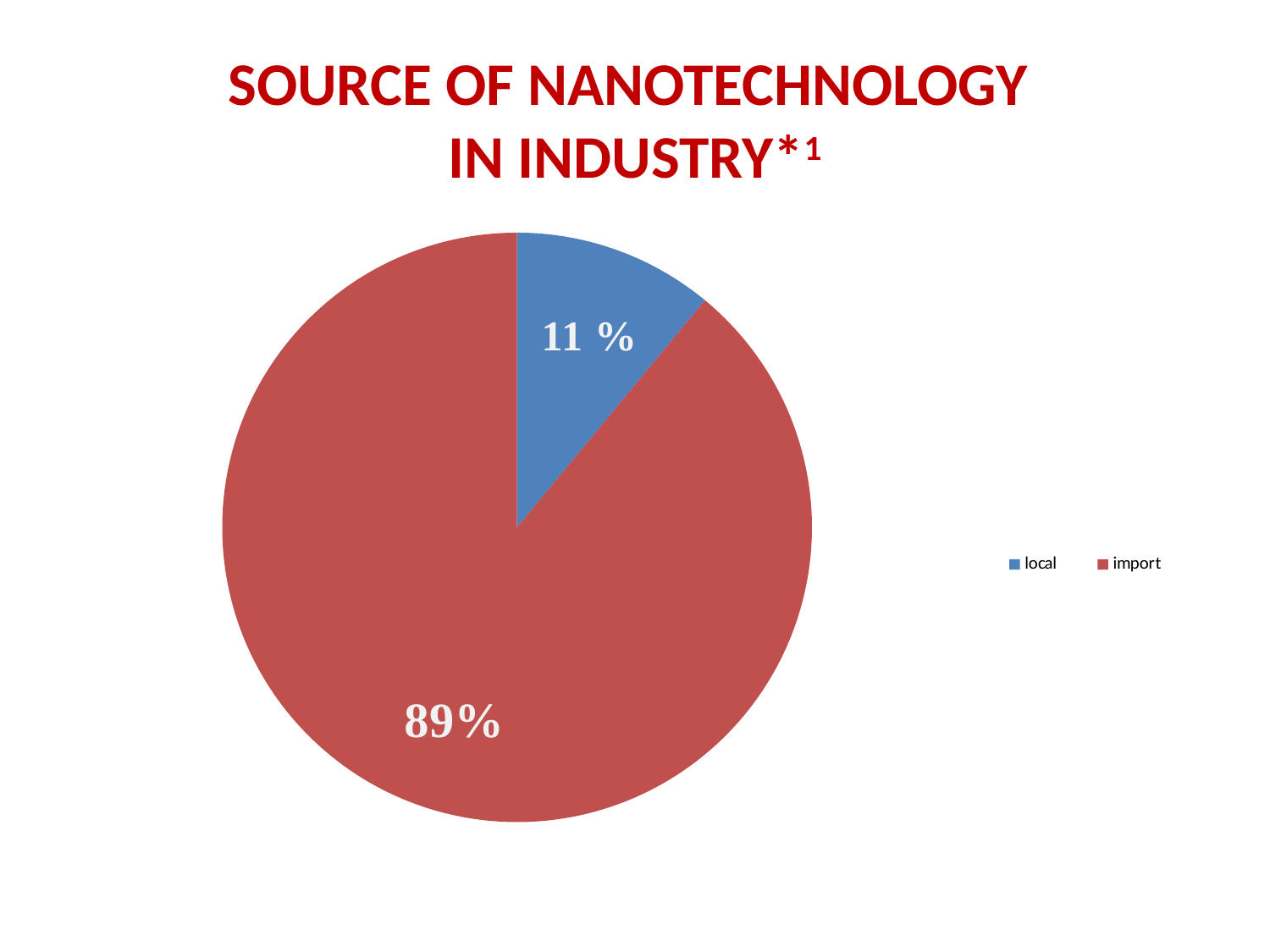
What is the title of the chart on the slide? SOURCE OF NANOTECHNOLOGY IN INDUSTRY*1 How many entries does the legend list? 2 What kind of chart is shown on the slide? pie chart Which is larger, the 'local' slice or the 'import' slice? import Which category has the largest slice of the pie? import How many categories are shown in the pie chart? 2 Which category has the smallest slice of the pie? local What colour is the 'local' slice in the pie chart? blue What share of the pie does the 'local' slice represent? 11 % What is the difference in percentage points between the 'import' and 'local' slices? 78 What share of the pie does the 'import' slice represent? 89%